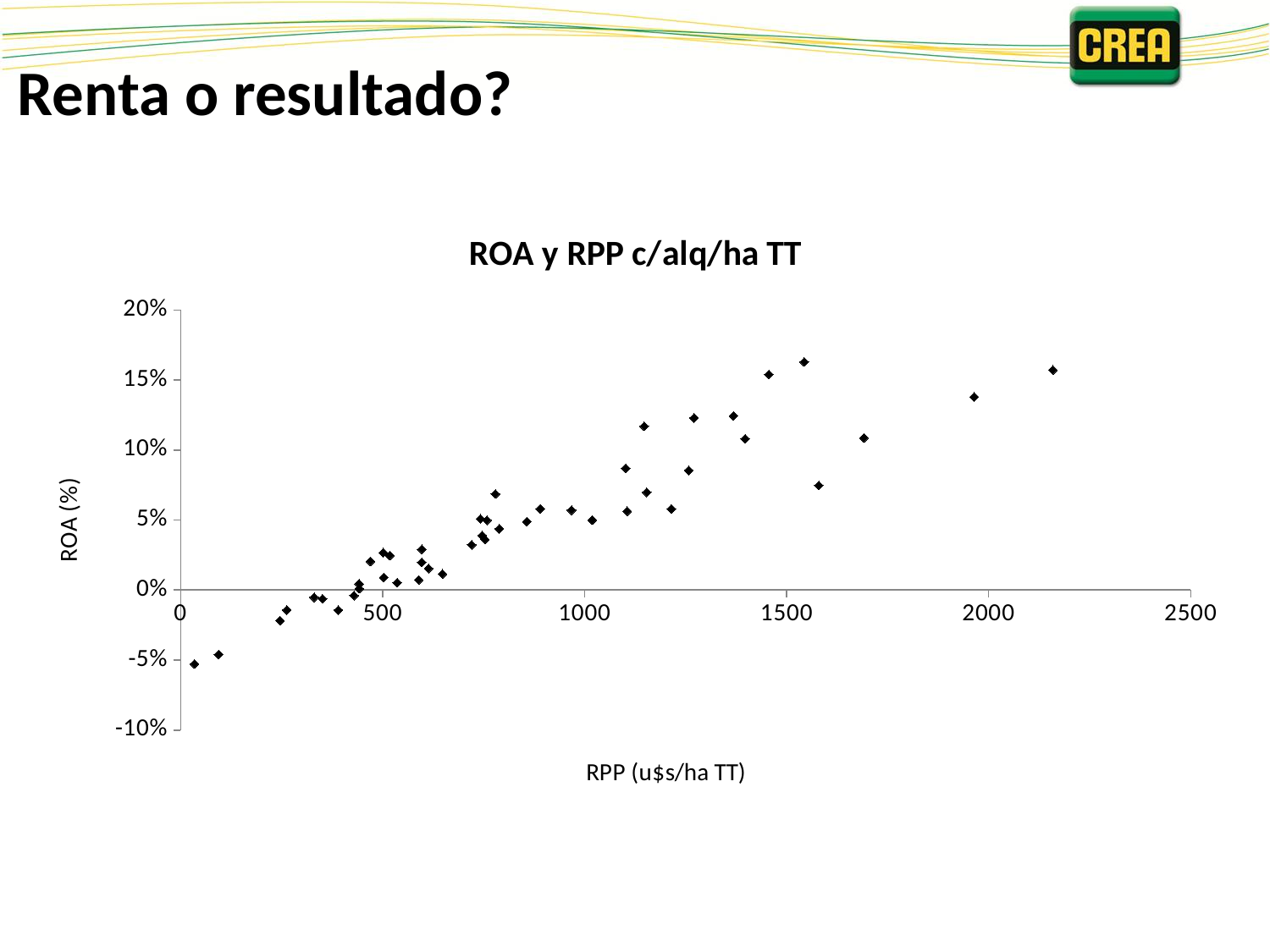
As RPP increases along the x axis, does ROA generally rise or fall? rise Is the lowest ROA value plotted on the chart greater or less than 0%? less Is the highest ROA value plotted on the chart greater or less than 15%? greater Is the ROA value for the point with the highest RPP (just above 2000) greater or less than 10%? greater What is the title of the chart? ROA y RPP c/alq/ha TT What is the maximum value shown on the horizontal axis? 2500 What is the label of the horizontal axis of the chart? RPP (u$s/ha TT) What kind of chart is shown on the slide? scatter chart